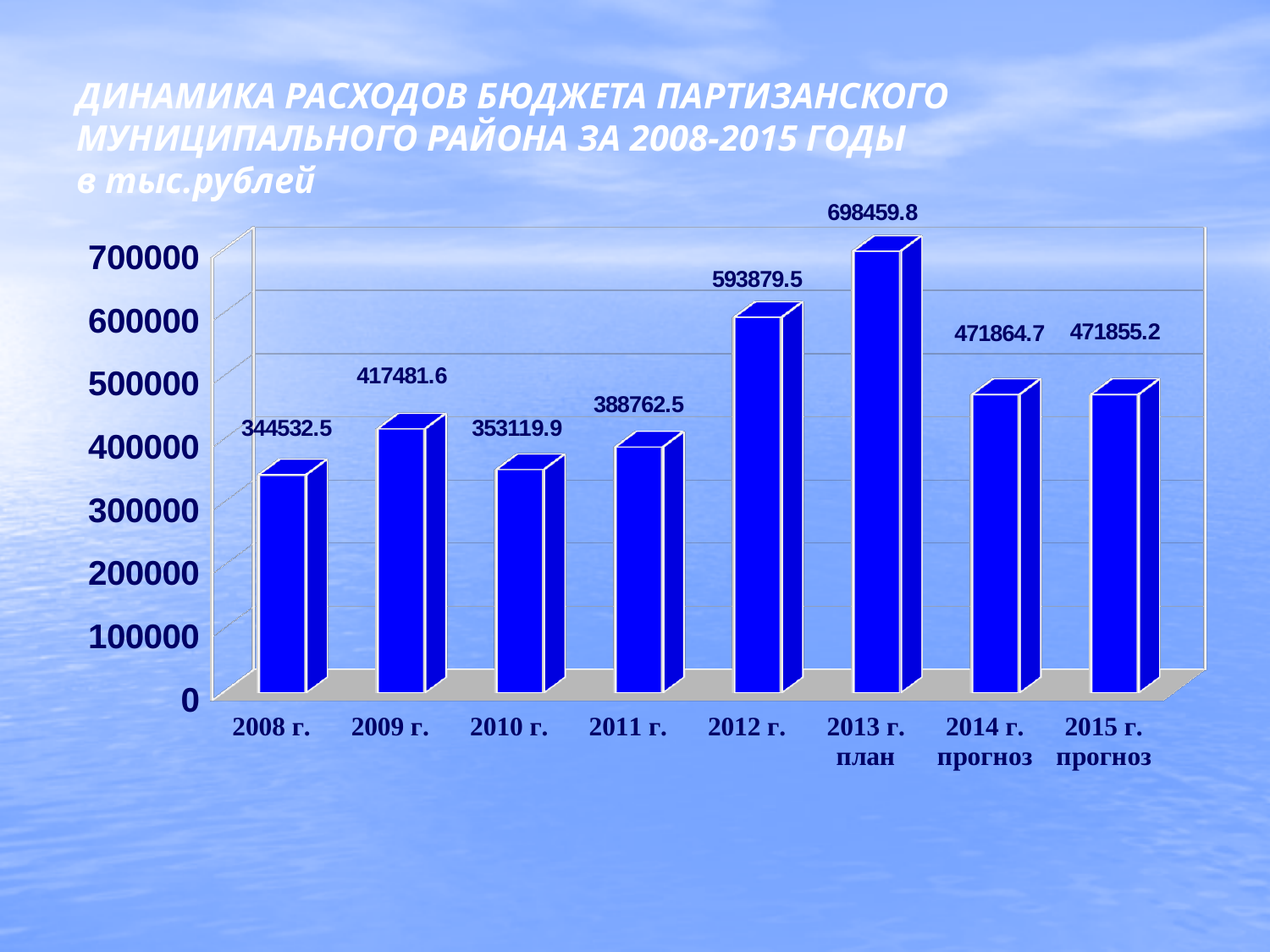
Which category has the lowest value? 2008 г. What unit is stated in the chart title? тыс.рублей What is the value for 2013 г. план? 698459.8 What is the value for 2008 г.? 344532.5 What is the value for 2011 г.? 388762.5 What is the difference between the values for 2009 г. and 2008 г.? 72949.1 Which is larger, the value for 2009 г. or the value for 2010 г.? 2009 г. What is the difference between the values for 2013 г. план and 2012 г.? 104580.3 How many categories are shown on the x axis? 8 What kind of chart is shown on the slide? bar chart Is the value for 2012 г. greater or less than 500000? greater Which category has the highest value? 2013 г. план